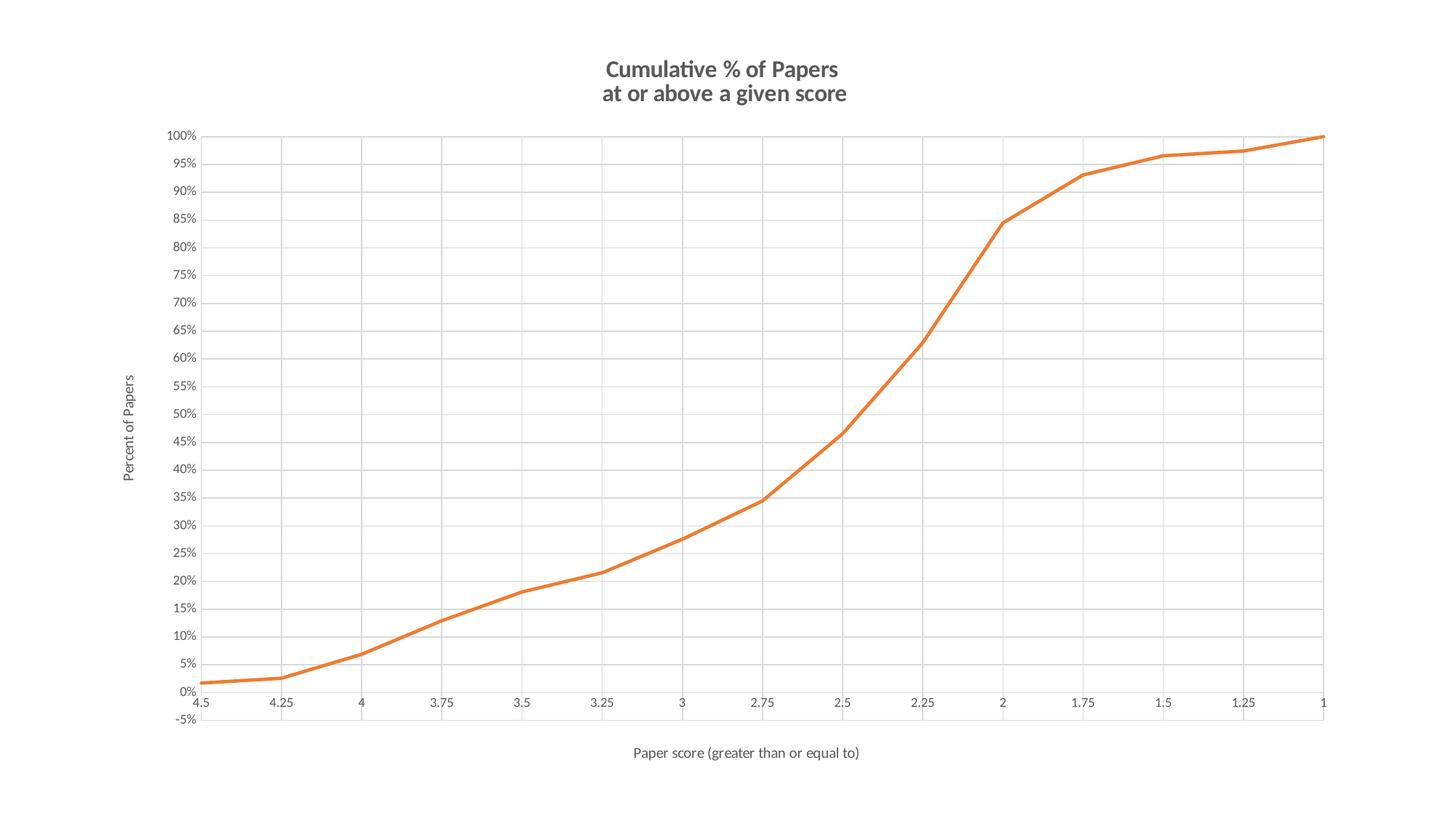
What is the label of the vertical axis? Percent of Papers Do the values rise or fall moving from left to right along the x axis? rise How many paper score categories are shown along the x axis? 15 What kind of chart is shown on the slide? line chart Which is larger, the value at a paper score of 2.25 or the value at a paper score of 3? 2.25 Is the value for a paper score of 2 greater or less than 80%? greater What is the title of the chart? Cumulative % of Papers at or above a given score What is the cumulative percent of papers at a paper score of 1? 100% At which paper score is the cumulative percent of papers highest? 1 Is the value for a paper score of 2.5 greater or less than 40%? greater At which paper score is the cumulative percent of papers lowest? 4.5 Is the value for a paper score of 3.5 greater or less than 20%? less